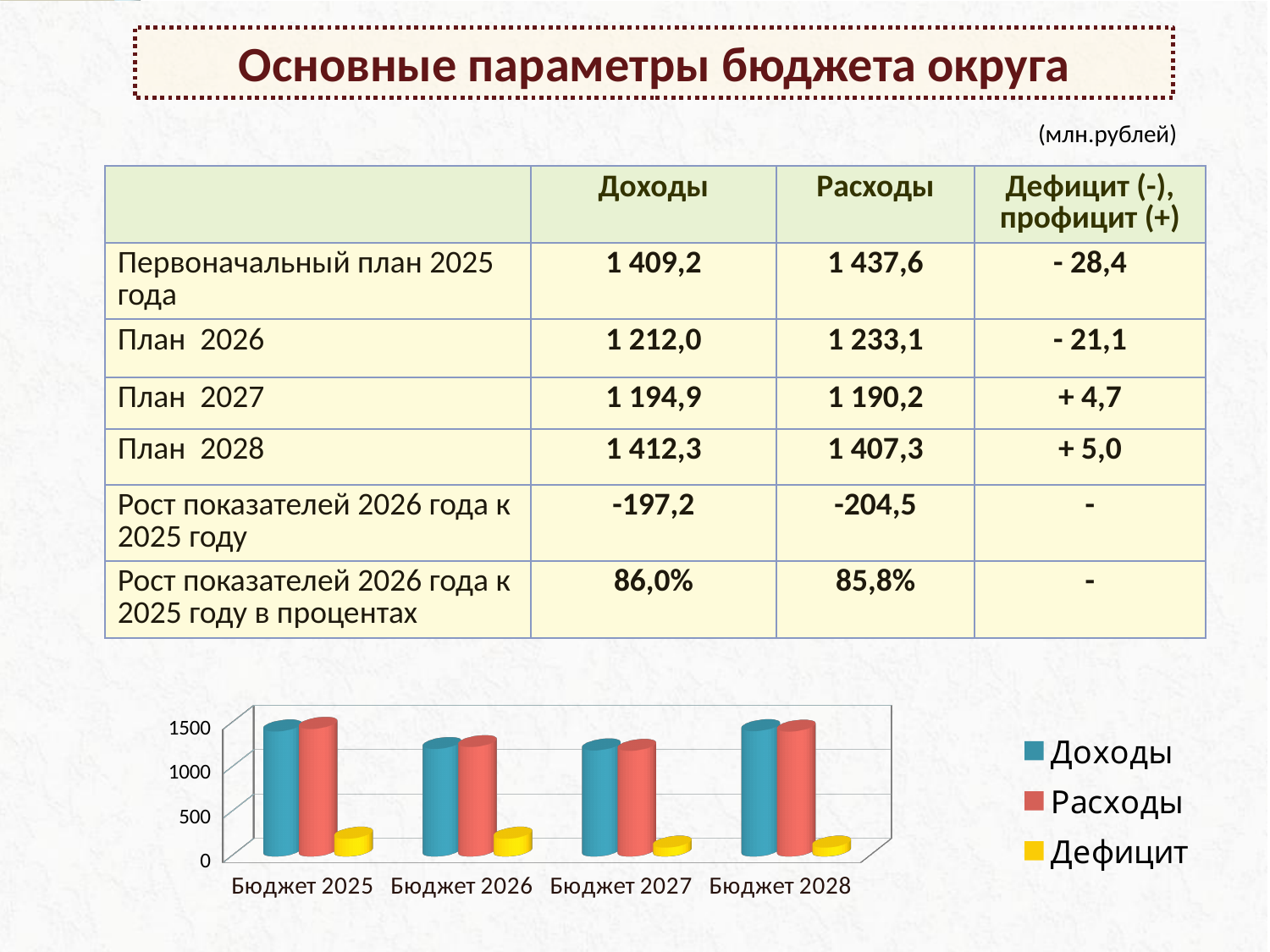
Is the Доходы value for Бюджет 2025 greater or less than 1000? greater Which has the larger Доходы value in the chart, Бюджет 2025 or Бюджет 2026? Бюджет 2025 What are the three legend entries of the chart? Доходы, Расходы, Дефицит Which has the larger Расходы value in the chart, Бюджет 2026 or Бюджет 2028? Бюджет 2028 Which colour represents Доходы in the chart? blue Is the Расходы value for Бюджет 2027 greater or less than 1000? greater How many categories are shown along the x axis of the chart? 4 Do the Доходы values rise or fall from Бюджет 2025 to Бюджет 2026 in the chart? fall What kind of chart is shown at the bottom of the slide? bar chart Is the Дефицит value for Бюджет 2027 greater or less than 500? less How many series does the chart's legend list? 3 Which series has the lowest value in every category of the chart? Дефицит